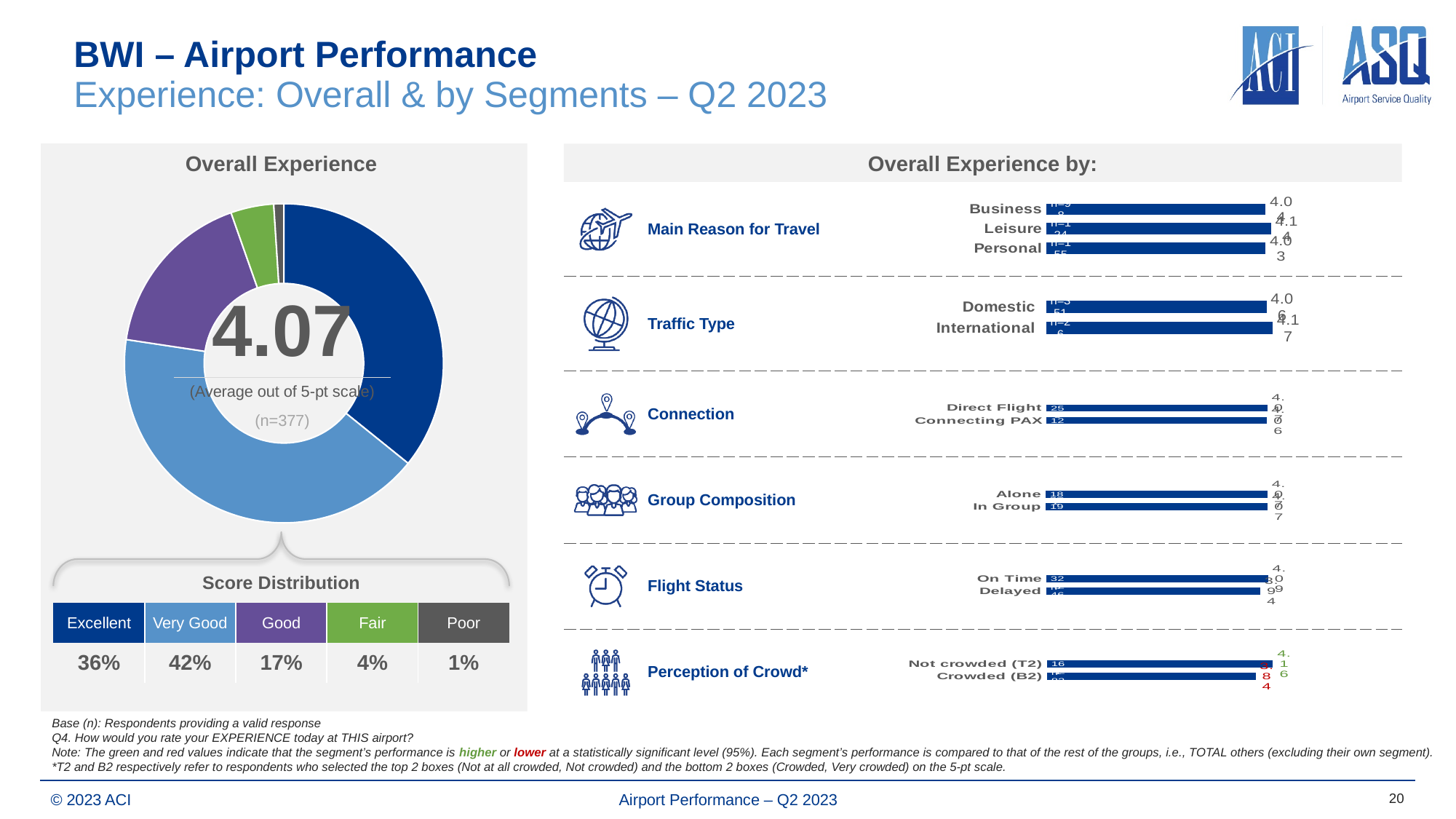
In the Overall Experience chart, what is the average score shown in the centre of the donut? 4.07 In the Overall Experience chart, which share is larger: Good or Fair? Good In the Overall Experience chart, what percentage of respondents rated their experience as Excellent? 36% In the Overall Experience chart, what percentage of respondents rated their experience as Poor? 1% In the Overall Experience chart, what is the difference in percentage points between the Very Good and Excellent shares? 6 How many rating categories are shown in the Score Distribution of the Overall Experience chart? 5 What kind of chart is the Overall Experience chart on the left of the slide? Donut (pie) chart In the Overall Experience chart, which rating category has the smallest share? Poor In the Overall Experience chart, which rating category has the largest share? Very Good In the Overall Experience chart, what is the sample size (n) shown in the centre of the donut? n=377 In the Overall Experience chart, what percentage of respondents rated their experience as Good? 17% In the Overall Experience chart, what percentage of respondents rated their experience as Very Good? 42%